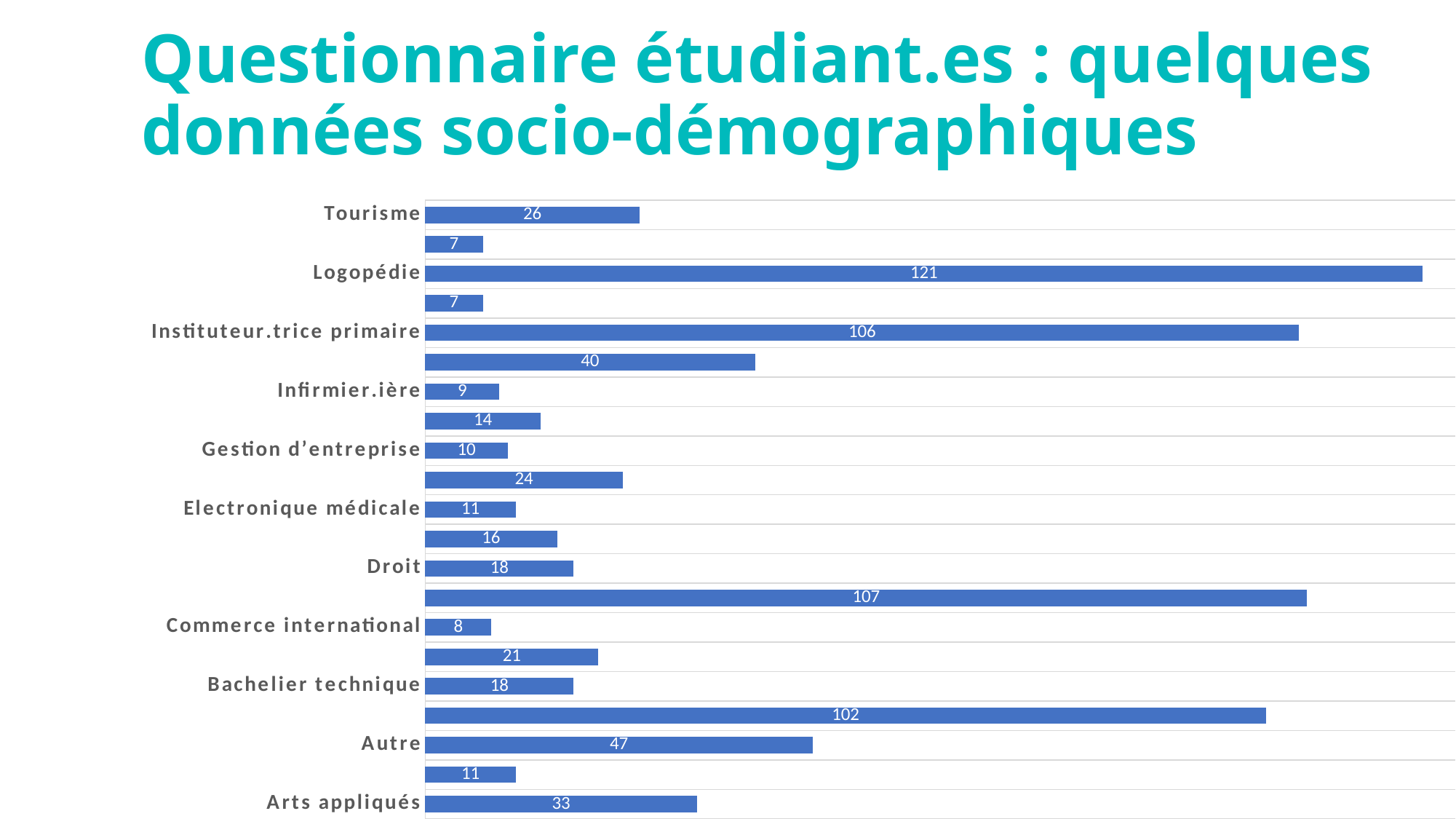
How many bars are plotted in the chart? 21 Which category has the highest value in the chart? Logopédie What is the value for Instituteur.trice primaire? 106 Which is larger, the value for Tourisme or the value for Droit? Tourisme What is the value for Logopédie? 121 What is the value for Commerce international? 8 What is the value for Arts appliqués? 33 What kind of chart is shown on the slide? Bar chart What is the difference between the values for Logopédie and Instituteur.trice primaire? 15 What is the value for Autre? 47 What is the difference between the values for Autre and Arts appliqués? 14 What is the value for Tourisme? 26